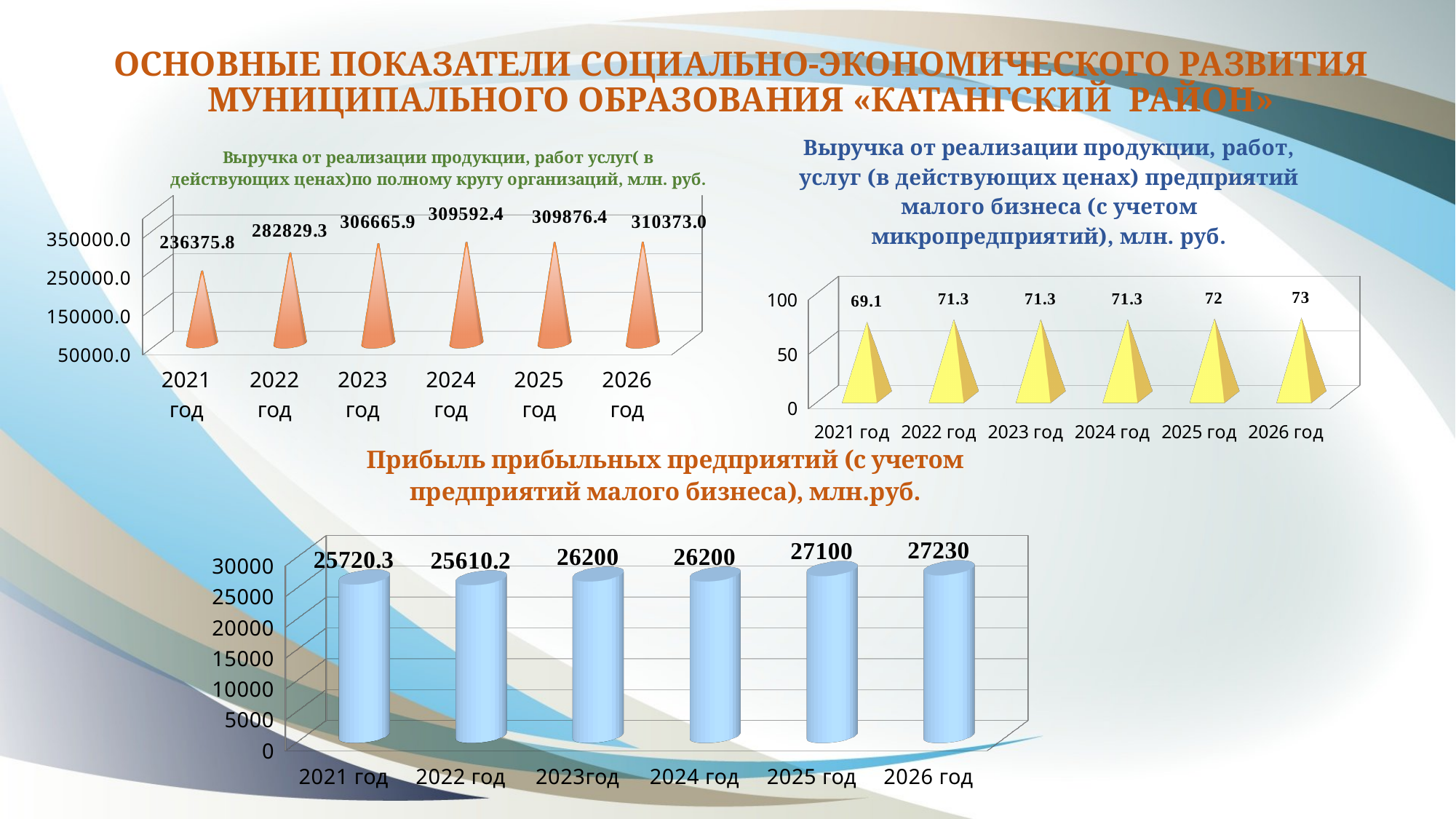
In the top-right chart (small business revenue), what is the value for 2025 год? 72 In the bottom chart (profit of profitable enterprises), which is larger: the value for 2025 год or 2023 год? 2025 год In the top-left chart (revenue for the full range of organisations), what is the value for 2021 год? 236375.8 In the bottom chart (profit of profitable enterprises), what is the value for 2022 год? 25610.2 In the top-left chart (revenue for the full range of organisations), what is the difference between the 2026 год and 2021 год values? 73997.2 In the top-right chart (small business revenue), which year has the lowest value? 2021 год In the top-right chart (small business revenue), what is the difference between the 2026 год and 2021 год values? 3.9 In the top-left chart (revenue for the full range of organisations), which year has the highest value? 2026 год In the bottom chart (profit of profitable enterprises), which year has the lowest value? 2022 год What kind of chart is the bottom chart (profit of profitable enterprises)? bar chart In the top-right chart (small business revenue), how many years are shown on the x axis? 6 In the top-left chart (revenue for the full range of organisations), do the values rise or fall from 2021 to 2026? rise